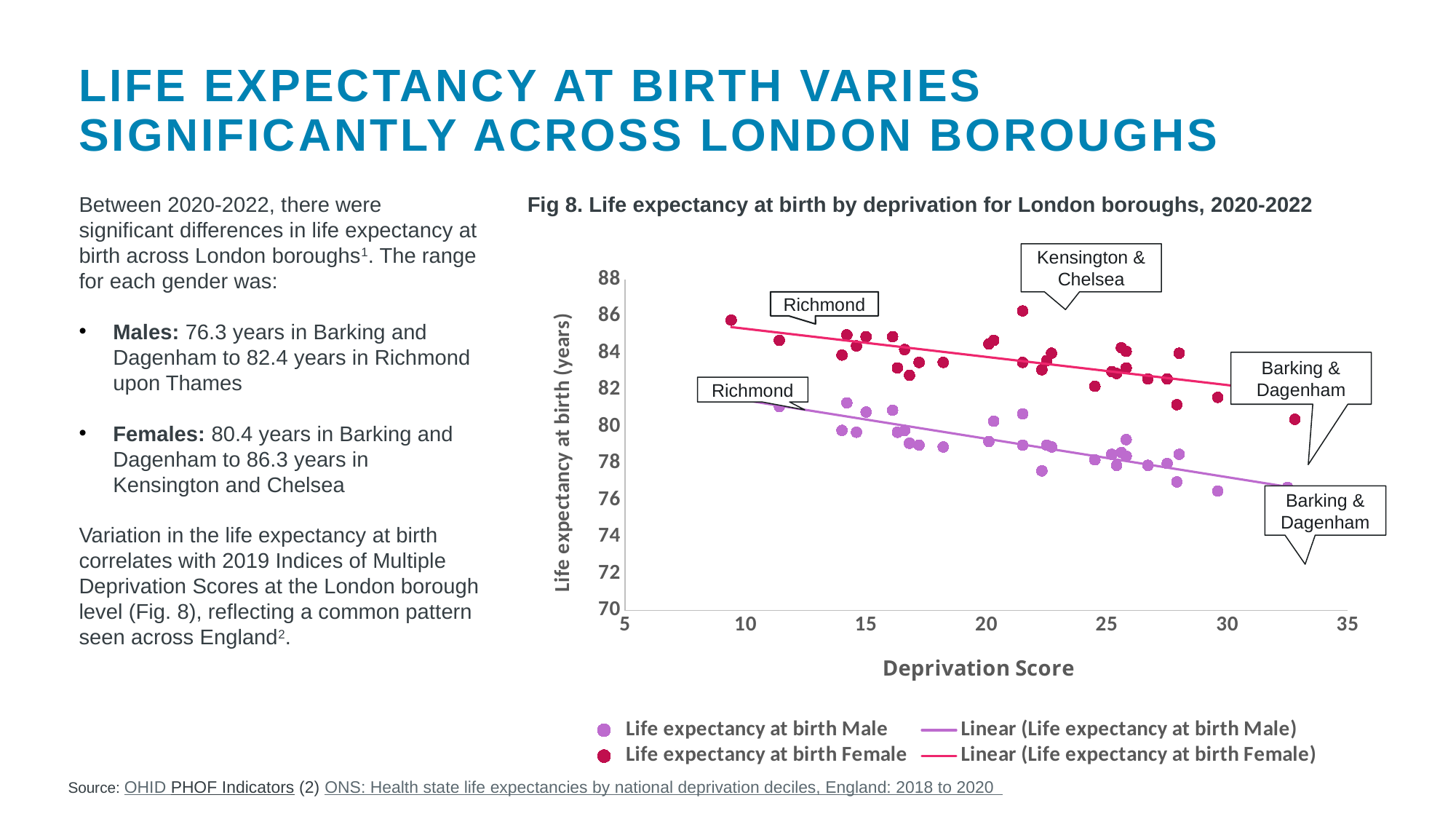
In Fig 8, do life expectancy values rise or fall as the deprivation score increases? Fall In Fig 8, is the male life expectancy at birth for Richmond greater or less than 80? greater How many entries does the legend of Fig 8 list? 4 In Fig 8, is the male life expectancy at birth for Barking & Dagenham greater or less than 78? less In Fig 8, is the female life expectancy at birth for Kensington & Chelsea greater or less than 86? greater What kind of chart is shown in Fig 8? Scatter chart In Fig 8, which borough is labelled as having the highest female life expectancy at birth? Kensington & Chelsea In Fig 8, which is higher for Richmond: the female or the male life expectancy at birth? Female In Fig 8, which borough is labelled as having the lowest male life expectancy at birth? Barking & Dagenham What is the title of the chart on the slide? Fig 8. Life expectancy at birth by deprivation for London boroughs, 2020-2022 What is the label of the x axis in Fig 8? Deprivation Score